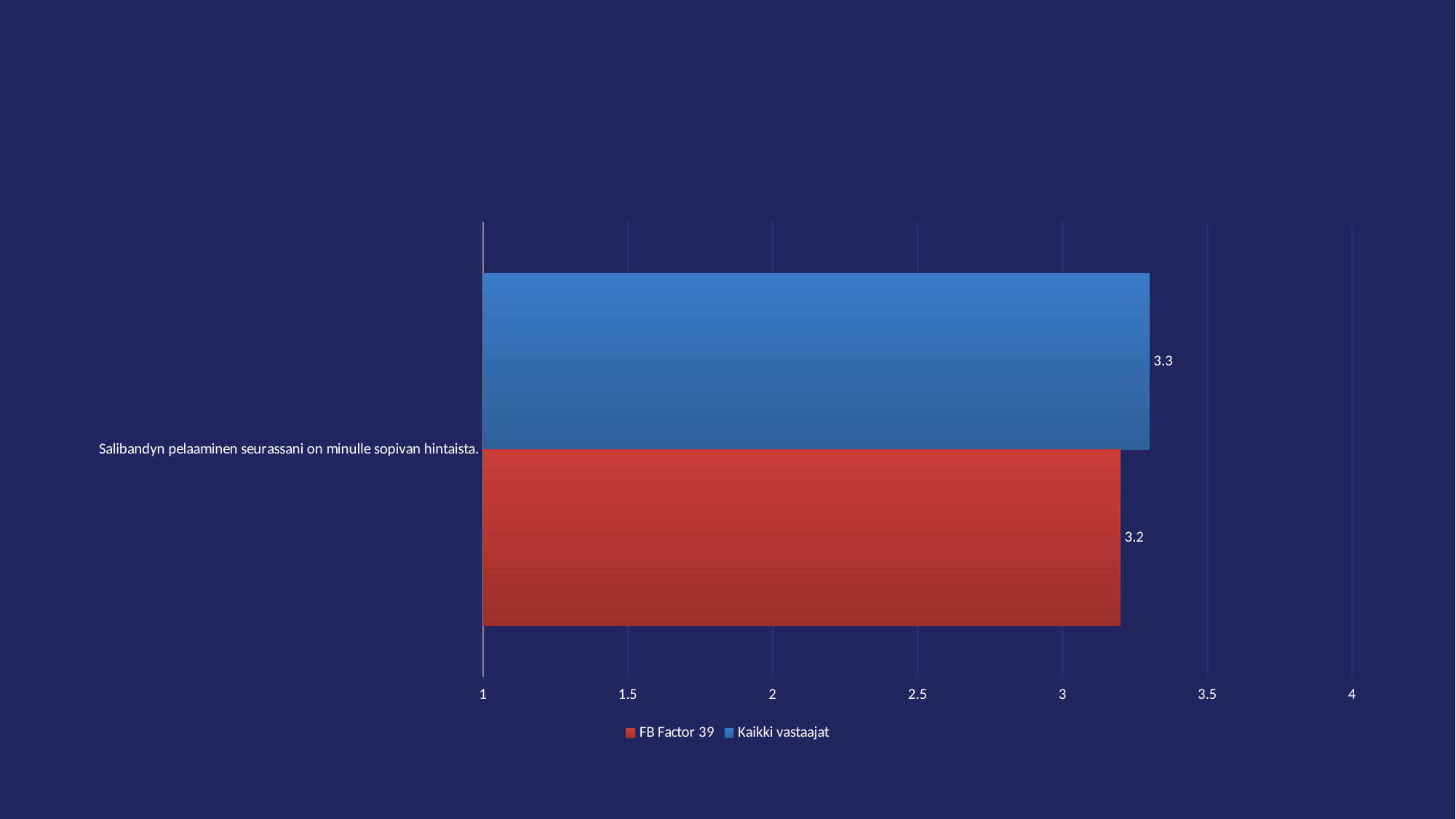
Is the value for FB Factor 39 greater or less than 3? greater How many series does the legend list? 2 What is the value for FB Factor 39 for "Salibandyn pelaaminen seurassani on minulle sopivan hintaista."? 3.2 What is the highest value shown on the x axis? 4 What kind of chart is shown on the slide? Bar chart What is the difference between the Kaikki vastaajat value and the FB Factor 39 value? 0.1 Is the value for Kaikki vastaajat greater or less than 3.5? less What is the value for Kaikki vastaajat for "Salibandyn pelaaminen seurassani on minulle sopivan hintaista."? 3.3 Which series is shown in red? FB Factor 39 Which series has the higher value: FB Factor 39 or Kaikki vastaajat? Kaikki vastaajat How many categories are shown on the chart? 1